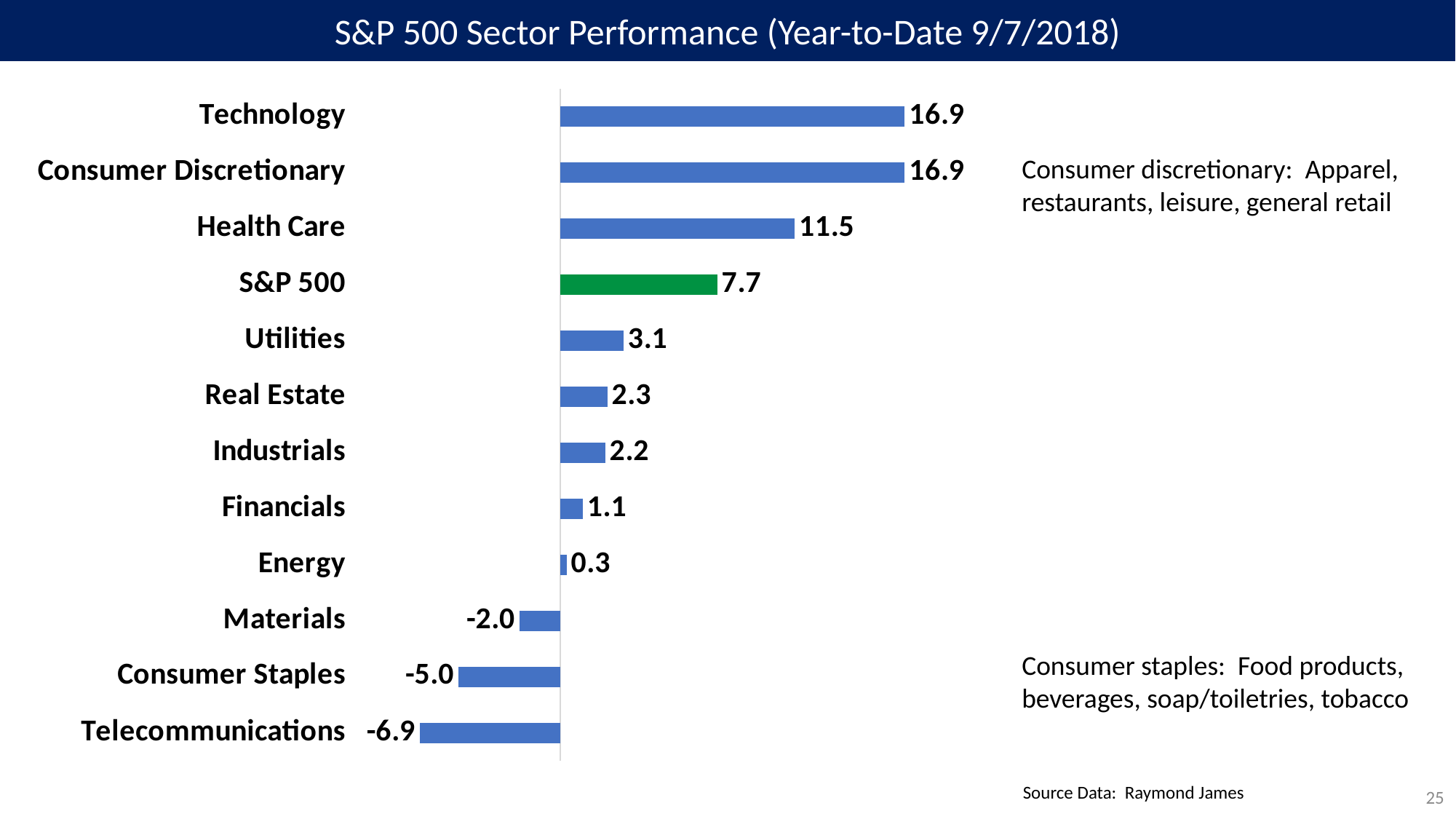
Which bar is coloured green rather than blue? S&P 500 Which has a larger value, Financials or Industrials? Industrials What is the value shown for Telecommunications? -6.9 How many categories are plotted on the chart? 12 Which has a larger value, Consumer Staples or Materials? Materials What is the year-to-date performance value shown for Health Care? 11.5 What is the difference between the Health Care value and the S&P 500 value? 3.8 What is the difference between the Utilities value and the Real Estate value? 0.8 Which category has the lowest value on the chart? Telecommunications What is the value shown for Energy? 0.3 What kind of chart is shown on the slide? Bar chart What value is shown for the S&P 500 bar? 7.7